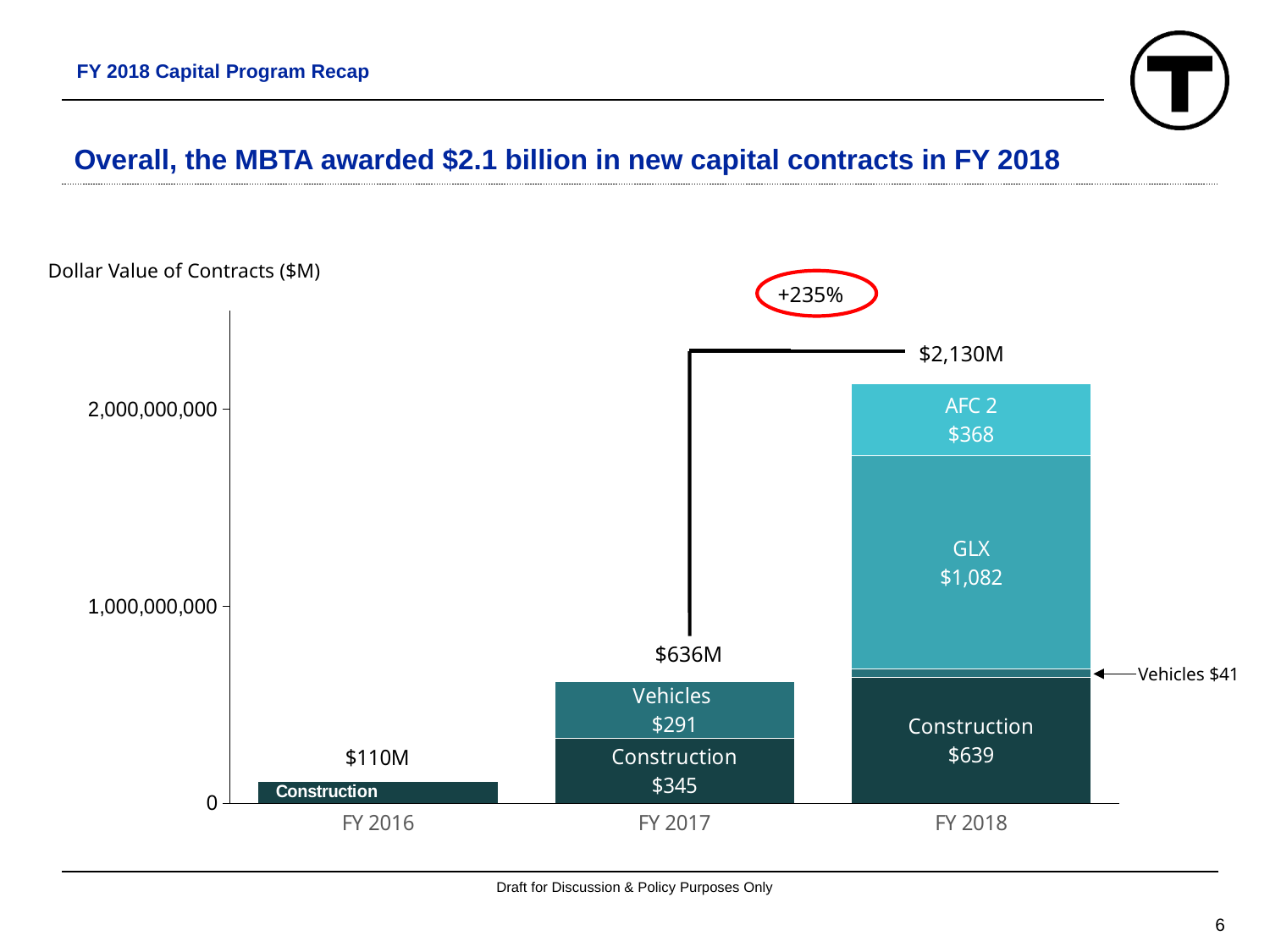
What is the value of the GLX segment in the FY 2018 bar? $1,082 What is the value of the Vehicles segment in FY 2018? $41 Which fiscal year has the highest total dollar value of contracts? FY 2018 What is the difference between the Construction values for FY 2018 and FY 2017? $294 What is the value of the AFC 2 segment in FY 2018? $368 How many fiscal years are shown on the x axis? 3 Which is larger in FY 2017, the Vehicles segment or the Construction segment? Construction What is the value of the Construction segment in FY 2017? $345 What is the total dollar value of contracts for FY 2018? $2,130M What percentage increase is circled above the FY 2018 bar? +235% What is the total dollar value of contracts for FY 2017? $636M Which fiscal year has the lowest total dollar value of contracts? FY 2016